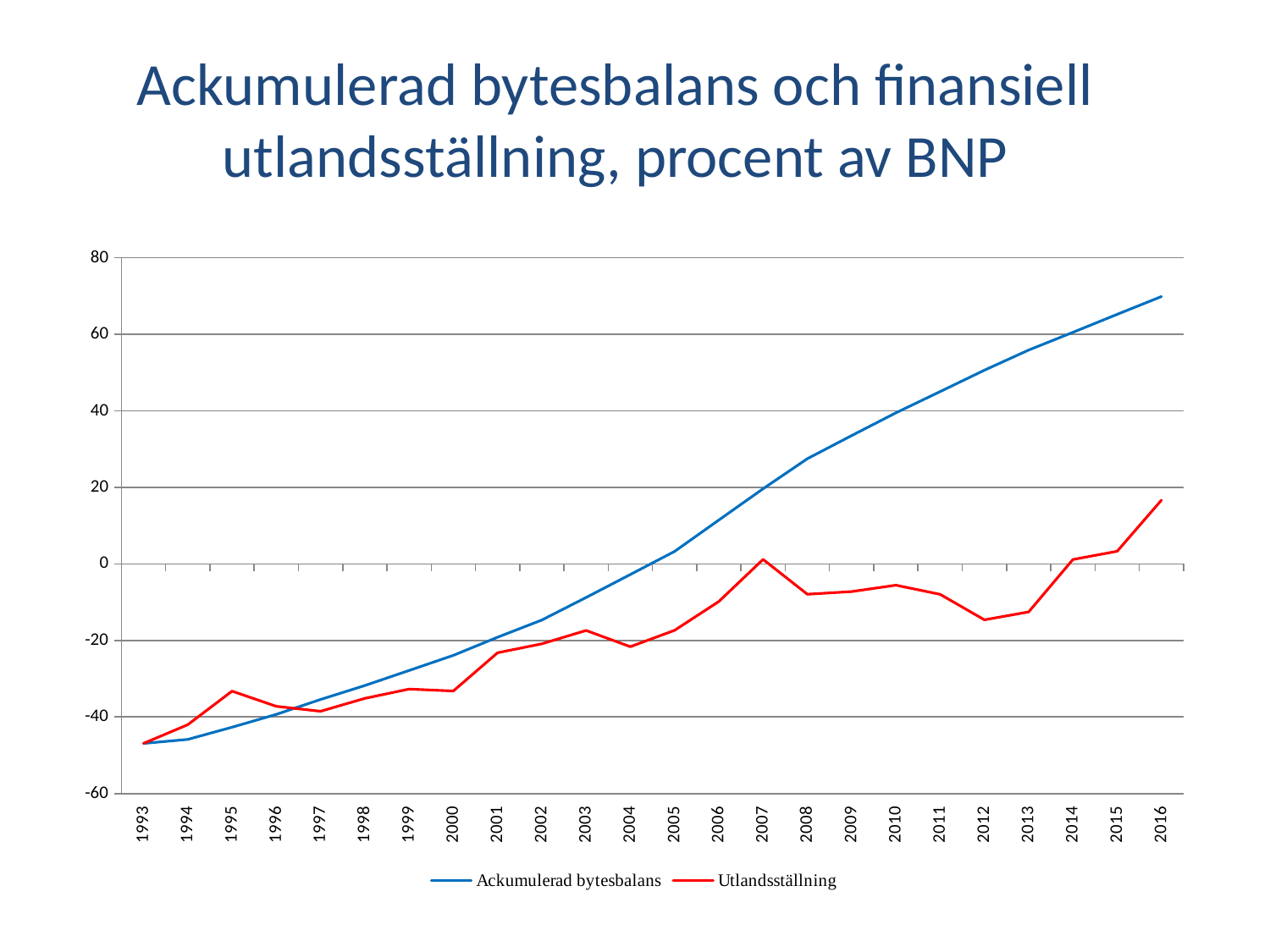
In which year is Ackumulerad bytesbalans at its highest? 2016 How many series does the legend list? 2 Is the value for Ackumulerad bytesbalans in 1993 greater or less than -40? less How many years are plotted along the x axis? 24 Is the value for Ackumulerad bytesbalans in 2016 greater or less than 60? greater Does the Ackumulerad bytesbalans line rise or fall from 1993 to 2016? rise In 1995, which series has the higher value, Ackumulerad bytesbalans or Utlandsställning? Utlandsställning Is the value for Utlandsställning in 2016 greater or less than 0? greater What kind of chart is shown on the slide? line chart In 2010, which series has the higher value, Ackumulerad bytesbalans or Utlandsställning? Ackumulerad bytesbalans In which year is Utlandsställning at its lowest? 1993